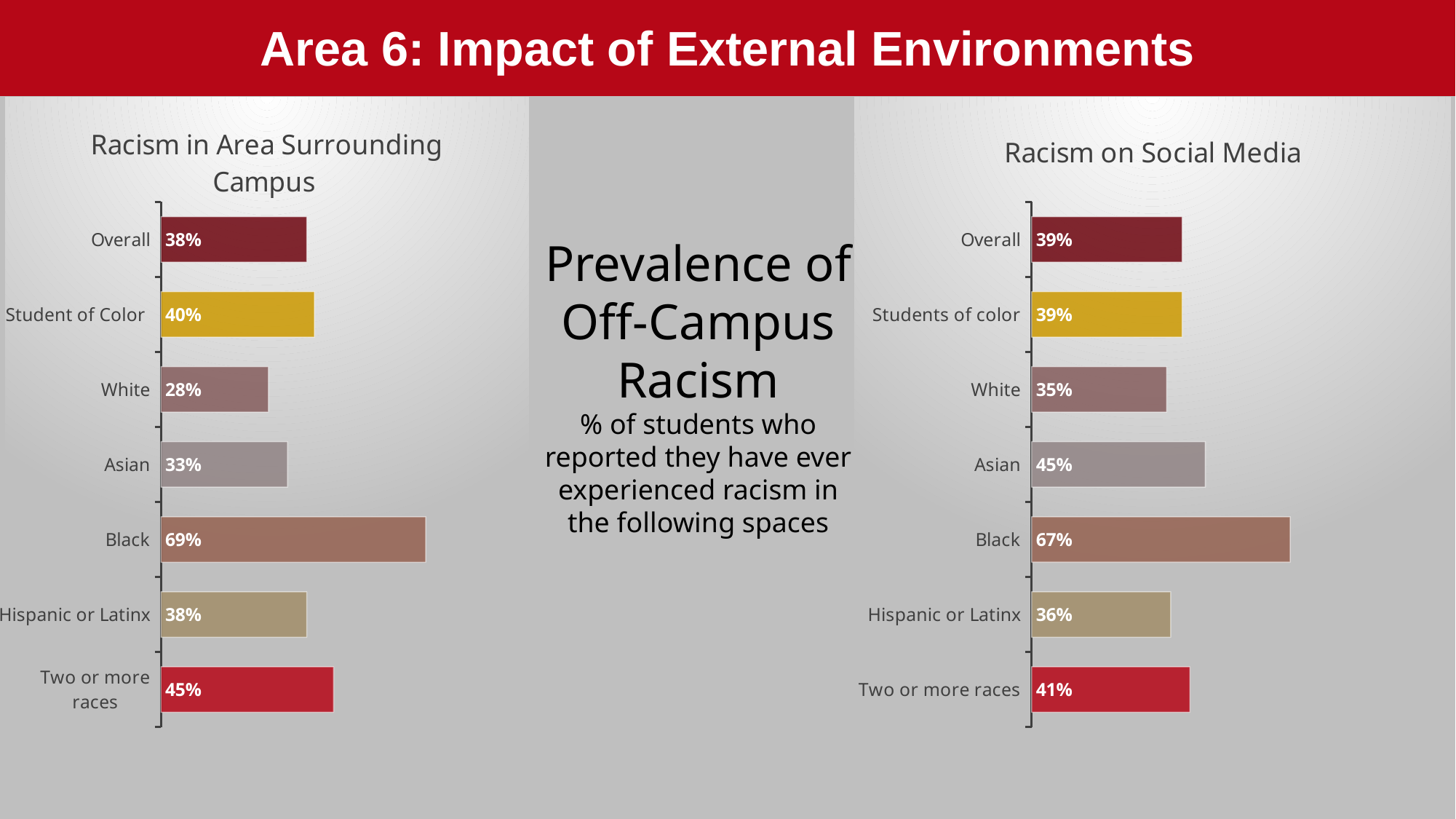
In the 'Racism on Social Media' chart, which category has the highest value? Black In the 'Racism in Area Surrounding Campus' chart, which is larger: the value for Asian or for Two or more races? Two or more races In the 'Racism in Area Surrounding Campus' chart, what is the difference between the values for Student of Color and White? 12% In the 'Racism in Area Surrounding Campus' chart, which category has the lowest value? White In the 'Racism on Social Media' chart, what is the value for Asian students? 45% In the 'Racism on Social Media' chart, what is the difference between the values for Black and White students? 32% In the 'Racism in Area Surrounding Campus' chart, what is the value for Black students? 69% How many categories are shown in the 'Racism on Social Media' chart? 7 What is the title of the chart on the right side of the slide? Racism on Social Media In the 'Racism on Social Media' chart, what is the value for Overall? 39% What kind of chart is 'Racism in Area Surrounding Campus'? Bar chart In the 'Racism in Area Surrounding Campus' chart, what is the value for Hispanic or Latinx students? 38%